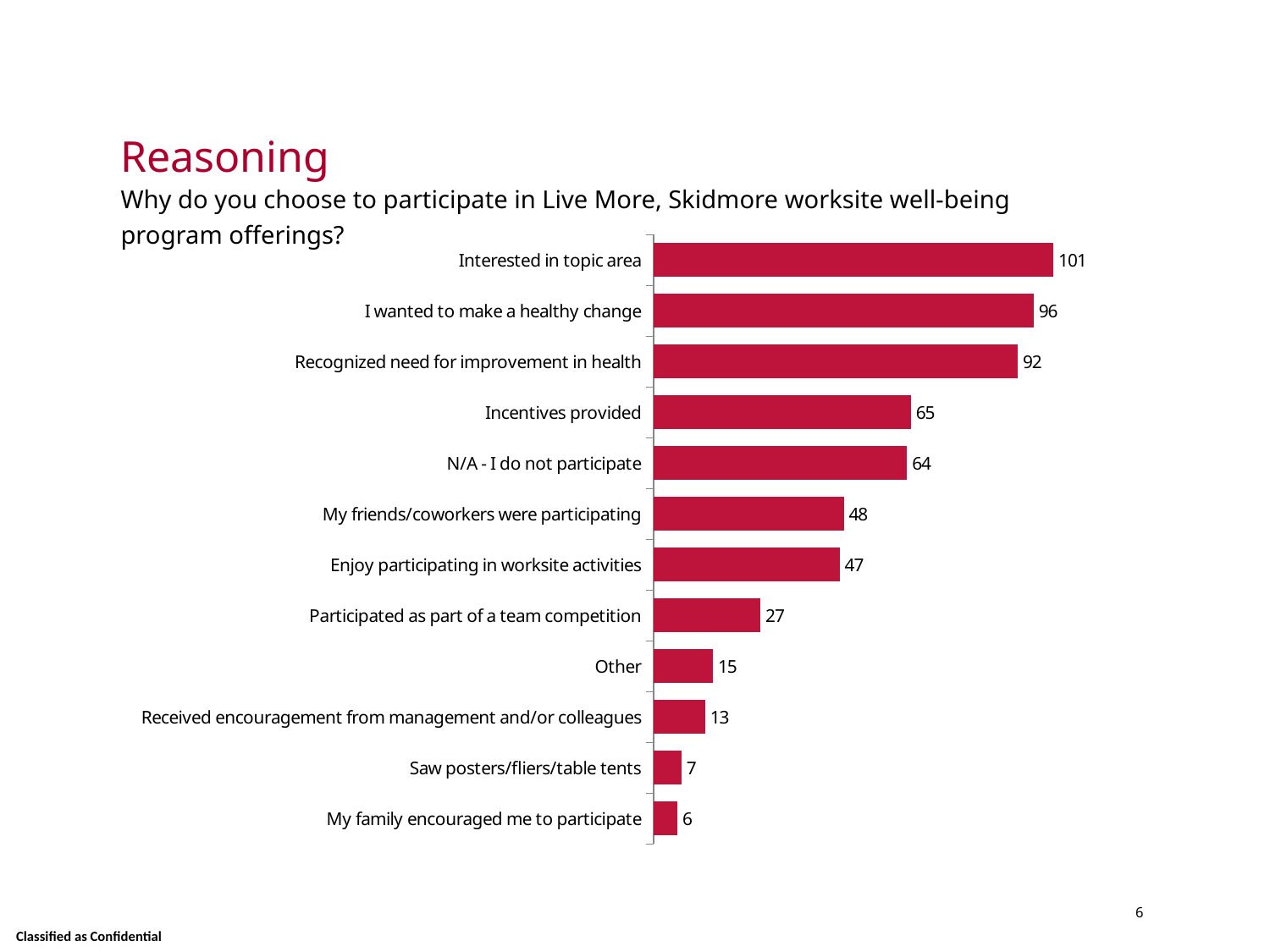
What is the value for "Interested in topic area"? 101 What is the value for "Participated as part of a team competition"? 27 Which is larger: "Incentives provided" or "My friends/coworkers were participating"? Incentives provided What is the difference between "I wanted to make a healthy change" and "Recognized need for improvement in health"? 4 What is the value for "Saw posters/fliers/table tents"? 7 How many categories are shown in the chart? 12 What colour are the bars in the chart? Red Which category has the lowest value? My family encouraged me to participate What kind of chart is shown on the slide? Bar chart What is the value for "Incentives provided"? 65 What is the difference between "Interested in topic area" and "Other"? 86 Which category has the highest value? Interested in topic area